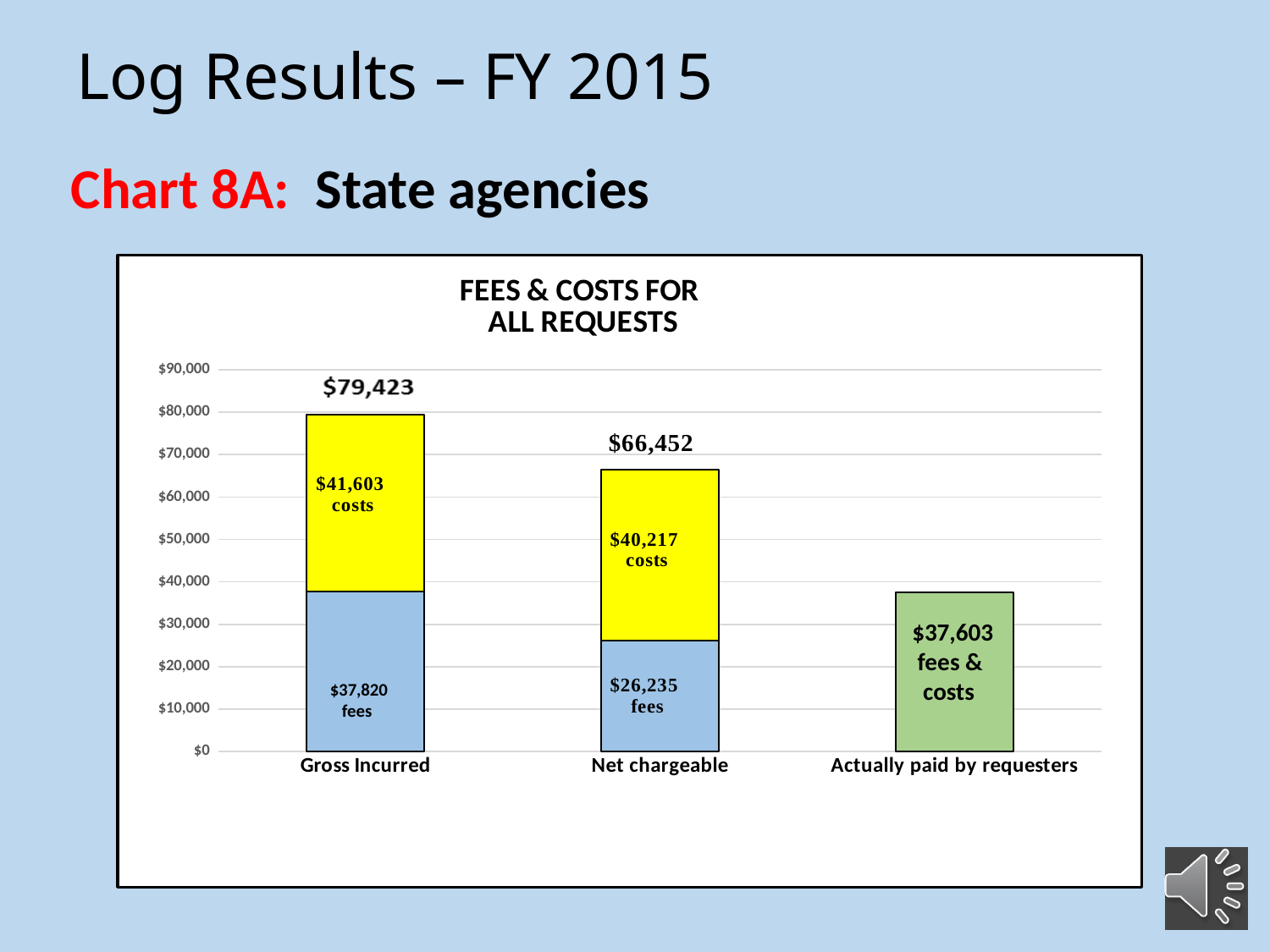
Which category has the highest total value? Gross Incurred How many categories are shown on the x axis? 3 Is the value for Actually paid by requesters greater or less than $40,000? less What is the total value shown for the Net chargeable bar? $66,452 What is the total value shown for the Gross Incurred bar? $79,423 What is the difference between the Gross Incurred total and the Net chargeable total? $12,971 Which category has the lowest total value? Actually paid by requesters What is the value for Actually paid by requesters? $37,603 What is the fees portion of the Gross Incurred bar? $37,820 Which is larger, the costs portion of Gross Incurred or the costs portion of Net chargeable? Gross Incurred What is the difference between the fees in Gross Incurred and the fees in Net chargeable? $11,585 What is the costs portion of the Net chargeable bar? $40,217